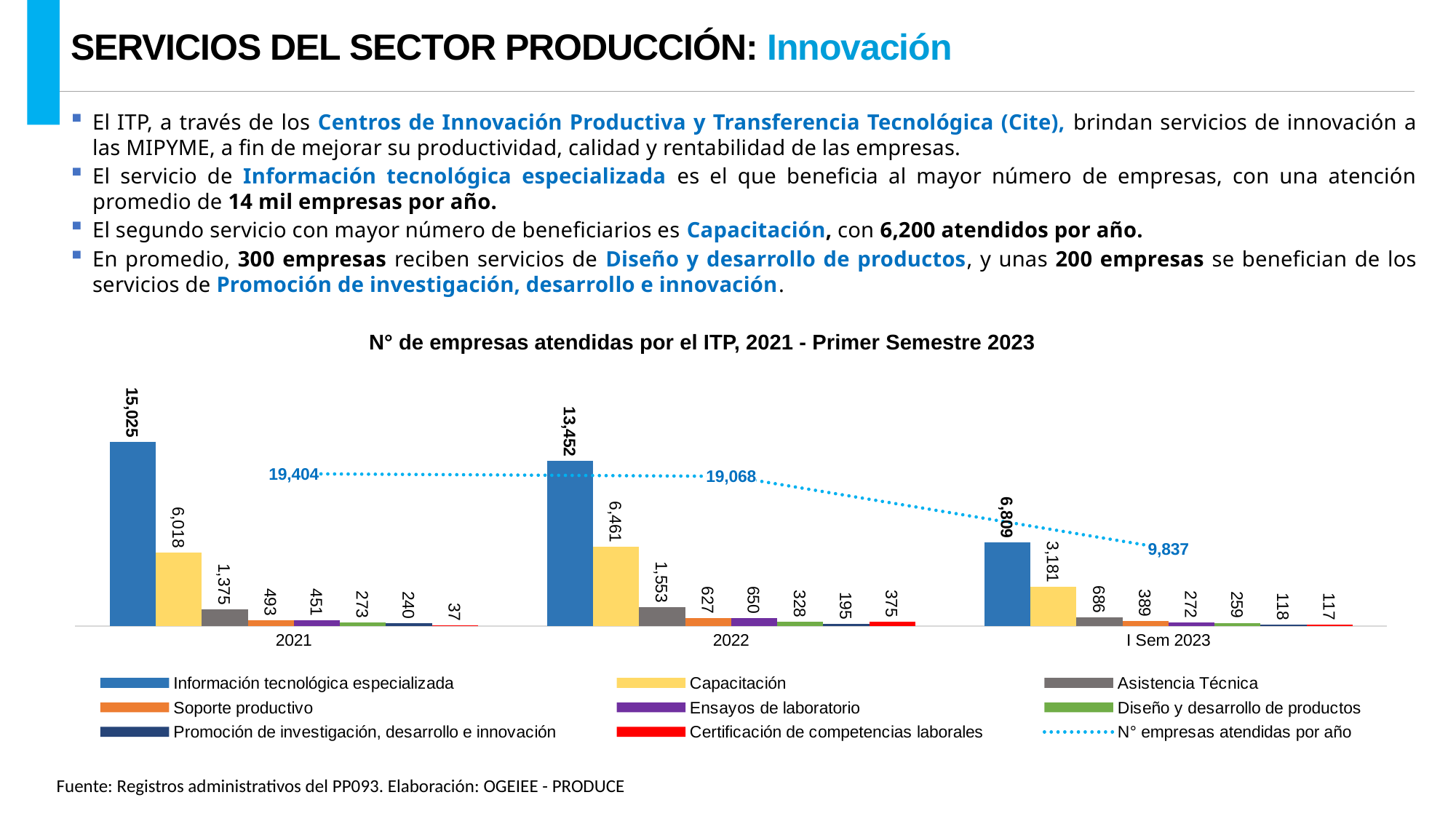
Which series has the lowest value in 2021? Certificación de competencias laborales What is the value for Información tecnológica especializada in 2021? 15,025 What is the value for Certificación de competencias laborales in 2022? 375 What is the difference between the N° empresas atendidas por año values for 2021 and 2022? 336 How many series does the legend list? 9 In 2022, which is larger: Ensayos de laboratorio or Soporte productivo? Ensayos de laboratorio What is the value of the N° empresas atendidas por año line for I Sem 2023? 9,837 In which period is the N° empresas atendidas por año line highest? 2021 By how much did Capacitación increase from 2021 to 2022? 443 Does the N° empresas atendidas por año line rise or fall from 2021 to I Sem 2023? Falls How many periods are shown on the x axis? 3 What is the value for Capacitación in 2022? 6,461